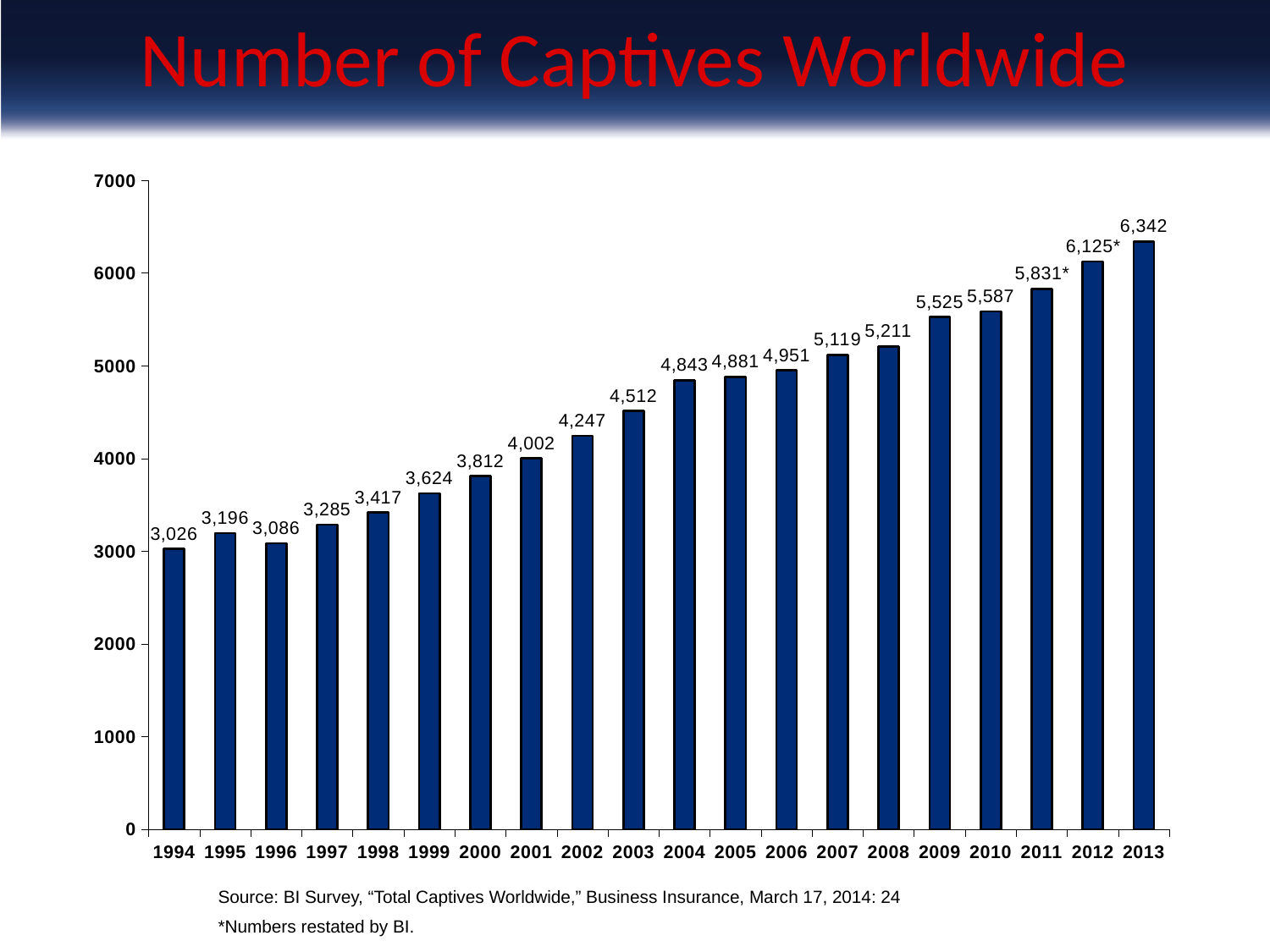
What is the difference between the number of captives in 2013 and in 2012? 217 What is the number of captives worldwide in 1994? 3,026 What kind of chart is shown on the slide? bar chart What is the number of captives worldwide in 2000? 3,812 Which year has the lowest number of captives worldwide? 1994 What is the title of the chart? Number of Captives Worldwide What is the number of captives worldwide in 2007? 5,119 Do the values generally rise or fall from 1994 to 2013? rise How many years are shown on the x axis of the chart? 20 Is the number of captives in 2009 greater or less than 5000? greater Which year has more captives, 1995 or 1996? 1995 Which year has the highest number of captives worldwide? 2013